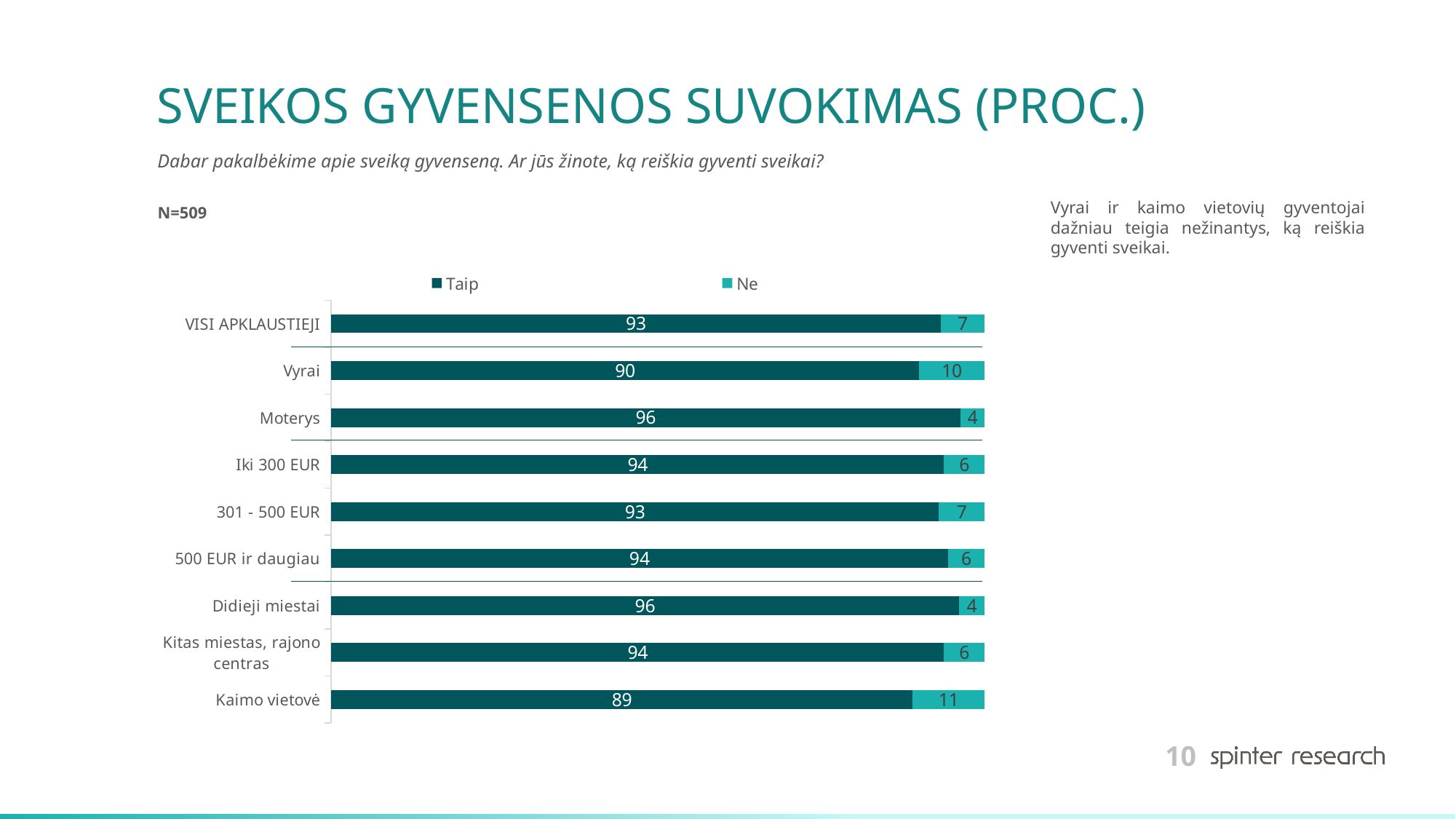
What kind of chart is shown on the slide? Stacked bar chart What is the difference between the "Taip" values for Moterys and Vyrai? 6 What is the "Ne" value for Kaimo vietovė? 11 Which category has the highest "Ne" value? Kaimo vietovė Which is larger, the "Ne" value for Vyrai or the "Ne" value for Didieji miestai? Vyrai Which category has the lowest "Taip" value? Kaimo vietovė What is the "Taip" value for VISI APKLAUSTIEJI? 93 How many series does the legend list? 2 What is the total of the stacked bar for Kaimo vietovė? 100 What is the "Taip" value for Vyrai? 90 How many categories are shown on the chart? 9 What is the "Ne" value for Moterys? 4